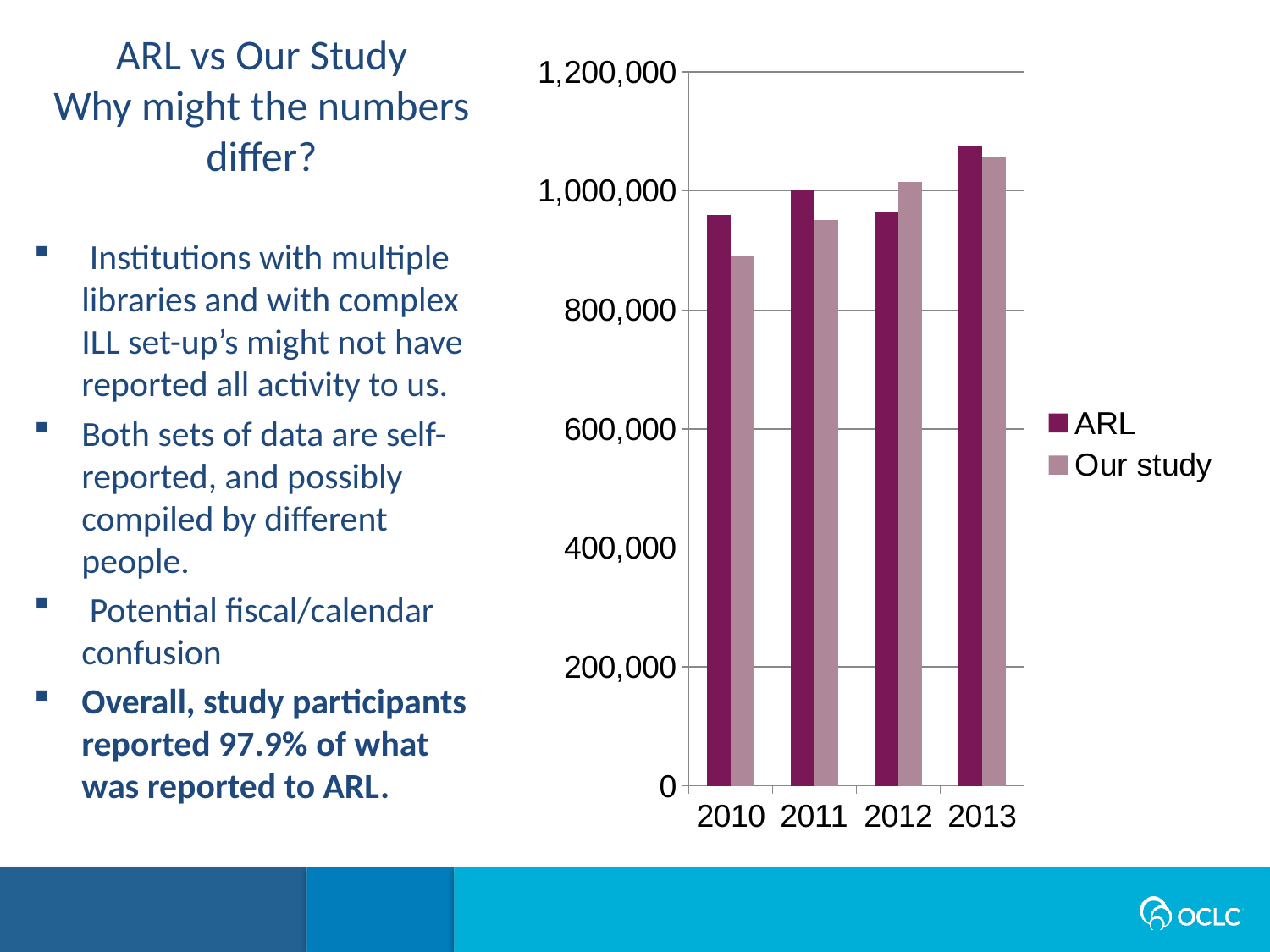
What kind of chart is shown on the slide? bar chart How many series does the chart's legend list? 2 Do the Our study values rise or fall from 2010 to 2013? rise Which two series are listed in the chart's legend? ARL and Our study How many years are shown on the x axis of the chart? 4 Is the ARL value for 2013 greater or less than 1,000,000? greater In which year is the Our study value lowest? 2010 In 2012, which series has the larger value, ARL or Our study? Our study Is the Our study value for 2010 greater or less than 1,000,000? less In which year is the Our study value highest? 2013 In 2010, which series has the larger value, ARL or Our study? ARL Is the ARL value for 2010 greater or less than 800,000? greater